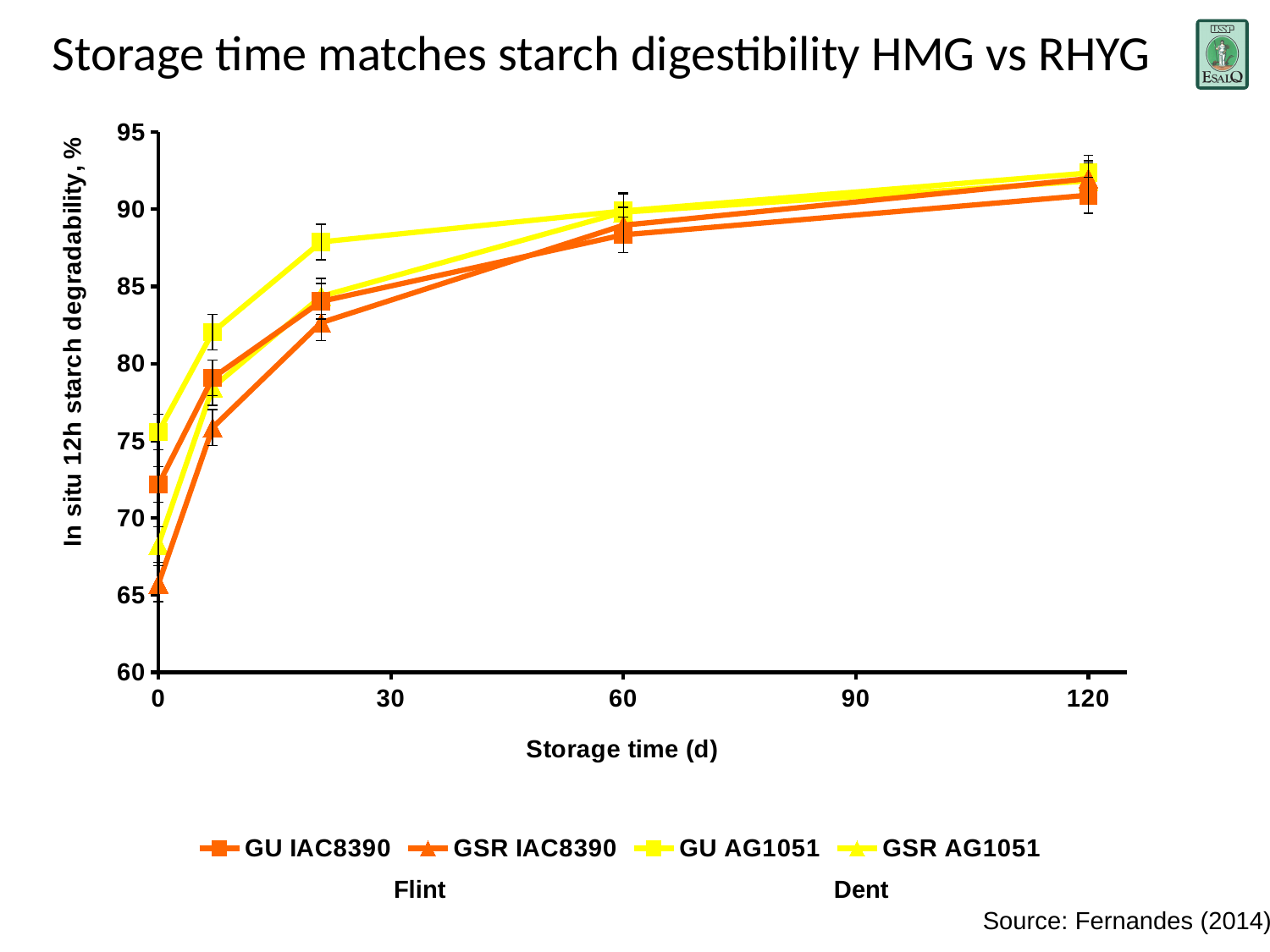
How many series does the legend list? 4 What is the label of the y axis? In situ 12h starch degradability, % Is the value for GSR IAC8390 at 120 days of storage greater or less than 90? greater Is the value for GSR IAC8390 at 0 days of storage greater or less than 70? less What is the label of the x axis? Storage time (d) At 0 days of storage, which is larger: the value for GU AG1051 or the value for GSR IAC8390? GU AG1051 Is the value for GU IAC8390 at 0 days of storage greater or less than 75? less Do the values for GU IAC8390 rise or fall as storage time increases? rise At 0 days of storage, which series has the highest in situ 12h starch degradability? GU AG1051 What kind of chart is shown on the slide? line chart At 0 days of storage, which series has the lowest in situ 12h starch degradability? GSR IAC8390